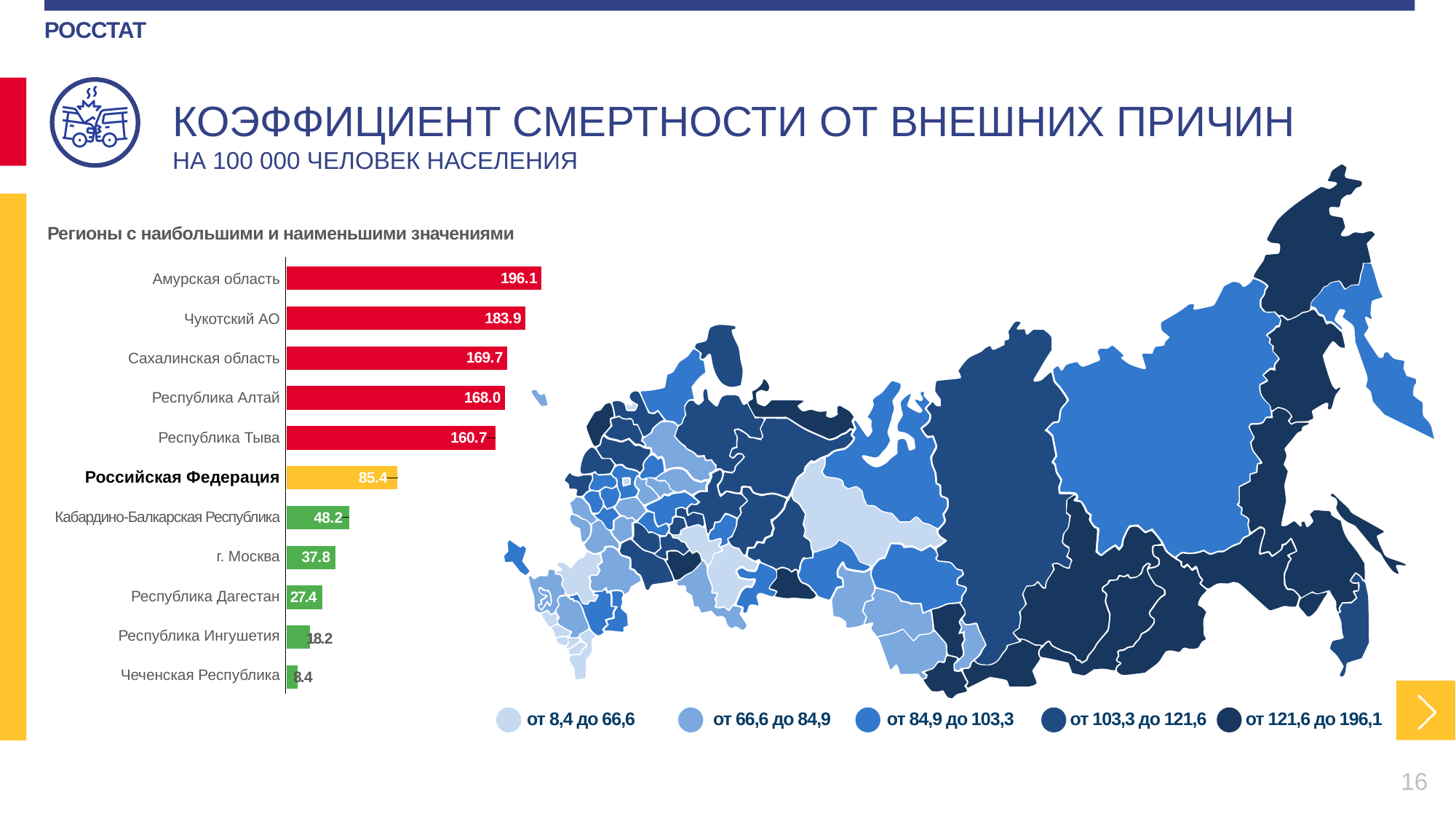
What is the value for Российская Федерация in the bar chart? 85.4 What is the difference between the values for Российская Федерация and Кабардино-Балкарская Республика? 37.2 What is the value for Сахалинская область in the bar chart? 169.7 What kind of chart is shown on the left of the slide? Bar chart What is the value for г. Москва in the bar chart? 37.8 What is the difference between the values for Амурская область and Чукотский АО? 12.2 What is the value for Амурская область in the bar chart? 196.1 Which region has the lowest value in the bar chart? Чеченская Республика Which has a larger value, Республика Дагестан or Республика Ингушетия? Республика Дагестан How many value ranges does the map legend list? 5 Which region has the highest value in the bar chart? Амурская область How many categories are shown in the bar chart? 11